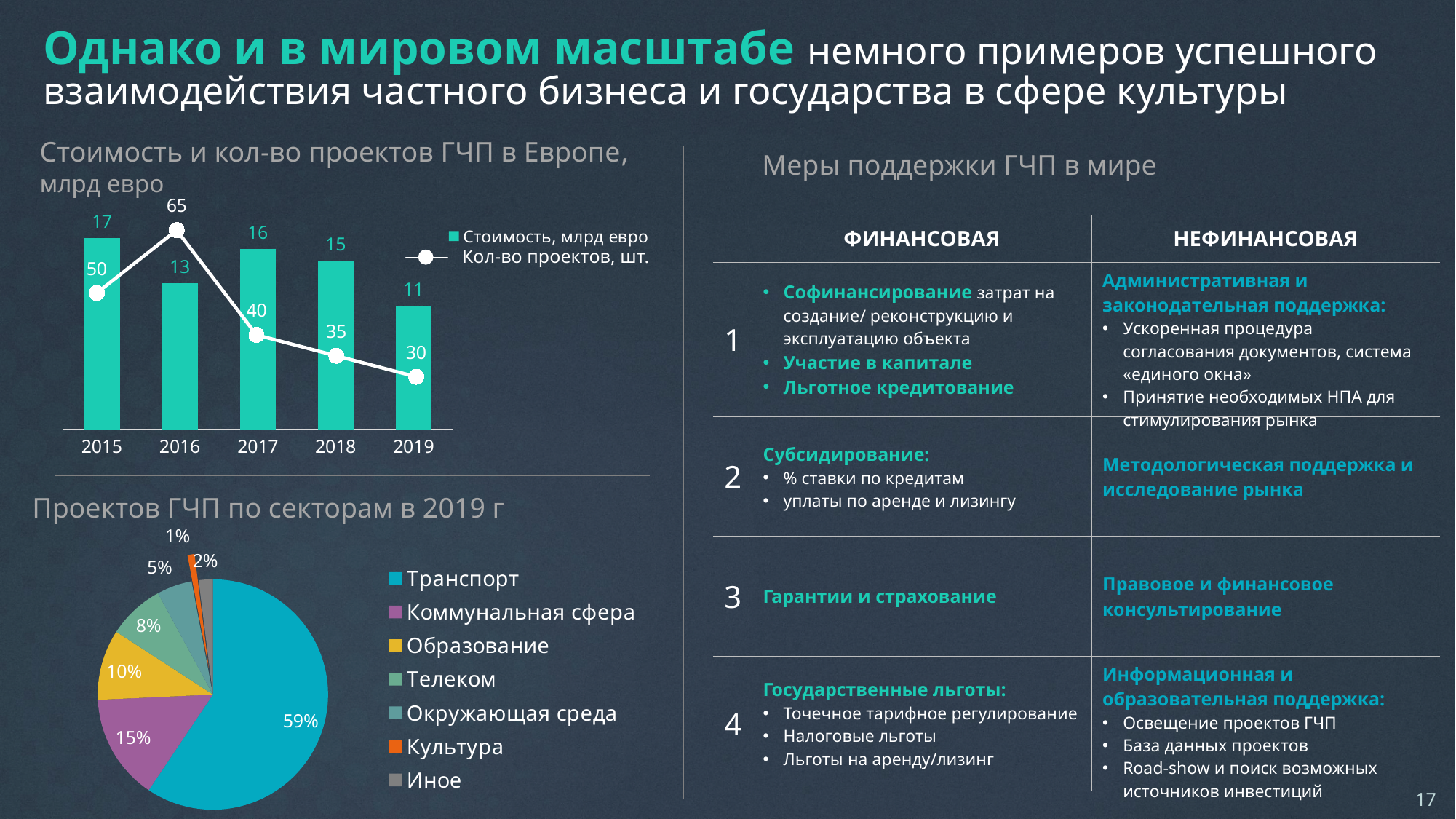
In the chart 'Стоимость и кол-во проектов ГЧП в Европе', which year has the highest 'Кол-во проектов, шт.'? 2016 In the chart 'Стоимость и кол-во проектов ГЧП в Европе', what is the value of 'Кол-во проектов, шт.' for 2016? 65 In the chart 'Стоимость и кол-во проектов ГЧП в Европе', which year has the lowest 'Стоимость, млрд евро'? 2019 In the pie chart 'Проектов ГЧП по секторам в 2019 г', what share does 'Транспорт' have? 59% How many series does the legend of the chart 'Стоимость и кол-во проектов ГЧП в Европе' list? 2 How many years are shown on the x axis of the chart 'Стоимость и кол-во проектов ГЧП в Европе'? 5 What kind of chart is 'Проектов ГЧП по секторам в 2019 г'? pie chart In the chart 'Стоимость и кол-во проектов ГЧП в Европе', what is the value of 'Стоимость, млрд евро' for 2015? 17 In the chart 'Стоимость и кол-во проектов ГЧП в Европе', does 'Кол-во проектов, шт.' rise or fall from 2016 to 2019? fall How many sectors does the legend of the pie chart 'Проектов ГЧП по секторам в 2019 г' list? 7 In the chart 'Стоимость и кол-во проектов ГЧП в Европе', which year has the larger 'Стоимость, млрд евро': 2017 or 2018? 2017 In the chart 'Стоимость и кол-во проектов ГЧП в Европе', what is the difference between 'Стоимость, млрд евро' in 2015 and in 2019? 6